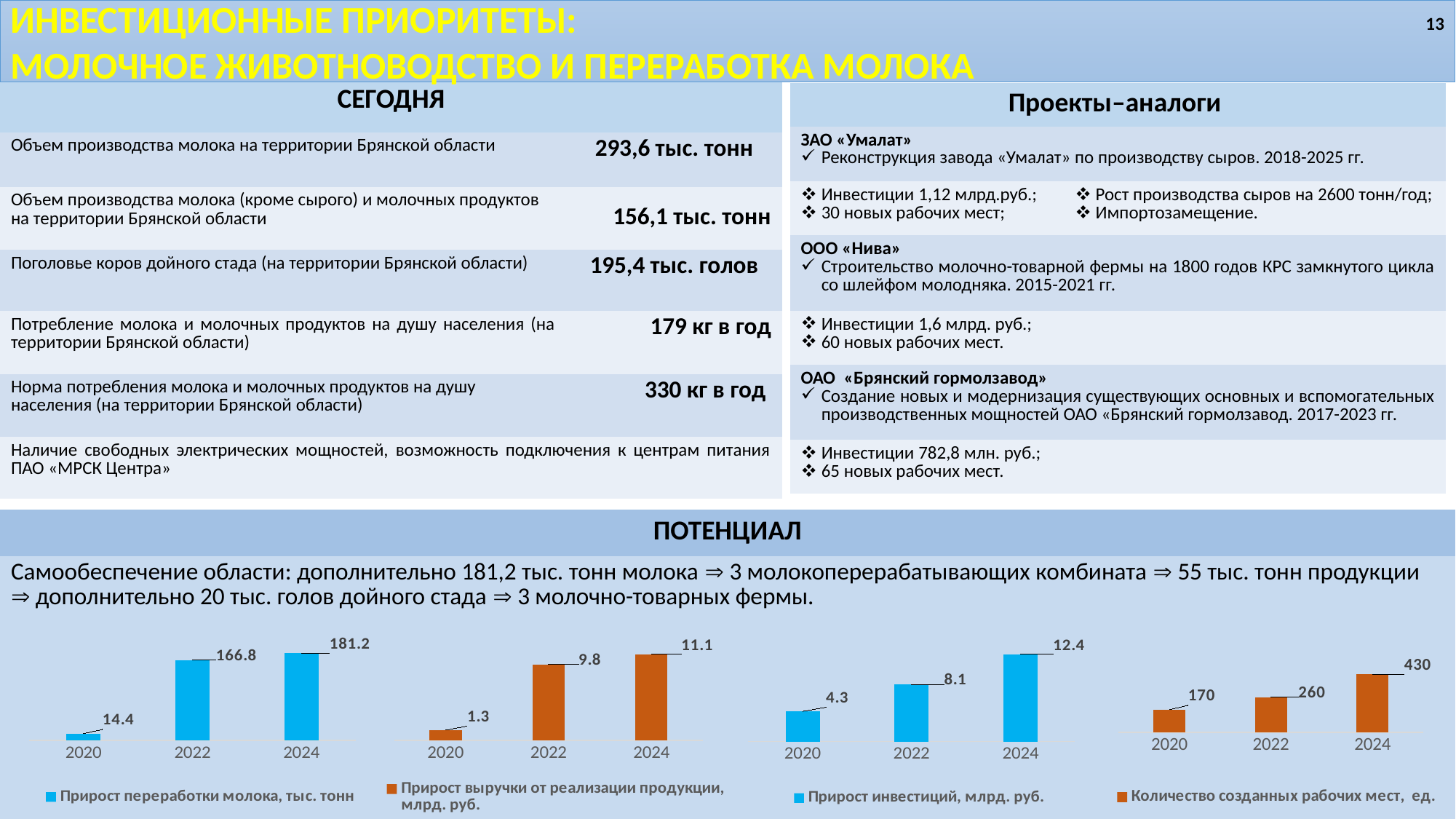
In the chart 'Прирост выручки от реализации продукции, млрд. руб.', what is the value for 2022? 9.8 In the chart 'Прирост инвестиций, млрд. руб.', which is larger: the value for 2020 or the value for 2022? 2022 How many bar charts are shown in the 'ПОТЕНЦИАЛ' section of the slide? 4 What kind of chart is the chart 'Прирост инвестиций, млрд. руб.'? bar chart In the chart 'Прирост переработки молока, тыс. тонн', what is the value for 2020? 14.4 How many categories (years) are shown in the chart 'Прирост выручки от реализации продукции, млрд. руб.'? 3 In the chart 'Прирост инвестиций, млрд. руб.', which year has the highest value? 2024 In the chart 'Прирост переработки молока, тыс. тонн', what is the value for 2024? 181.2 In the chart 'Количество созданных рабочих мест, ед.', which year has the lowest value? 2020 In the chart 'Количество созданных рабочих мест, ед.', what is the difference between the values for 2024 and 2022? 170 In the chart 'Количество созданных рабочих мест, ед.', do the values rise or fall from 2020 to 2024? rise In the chart 'Прирост переработки молока, тыс. тонн', what is the difference between the values for 2022 and 2020? 152.4